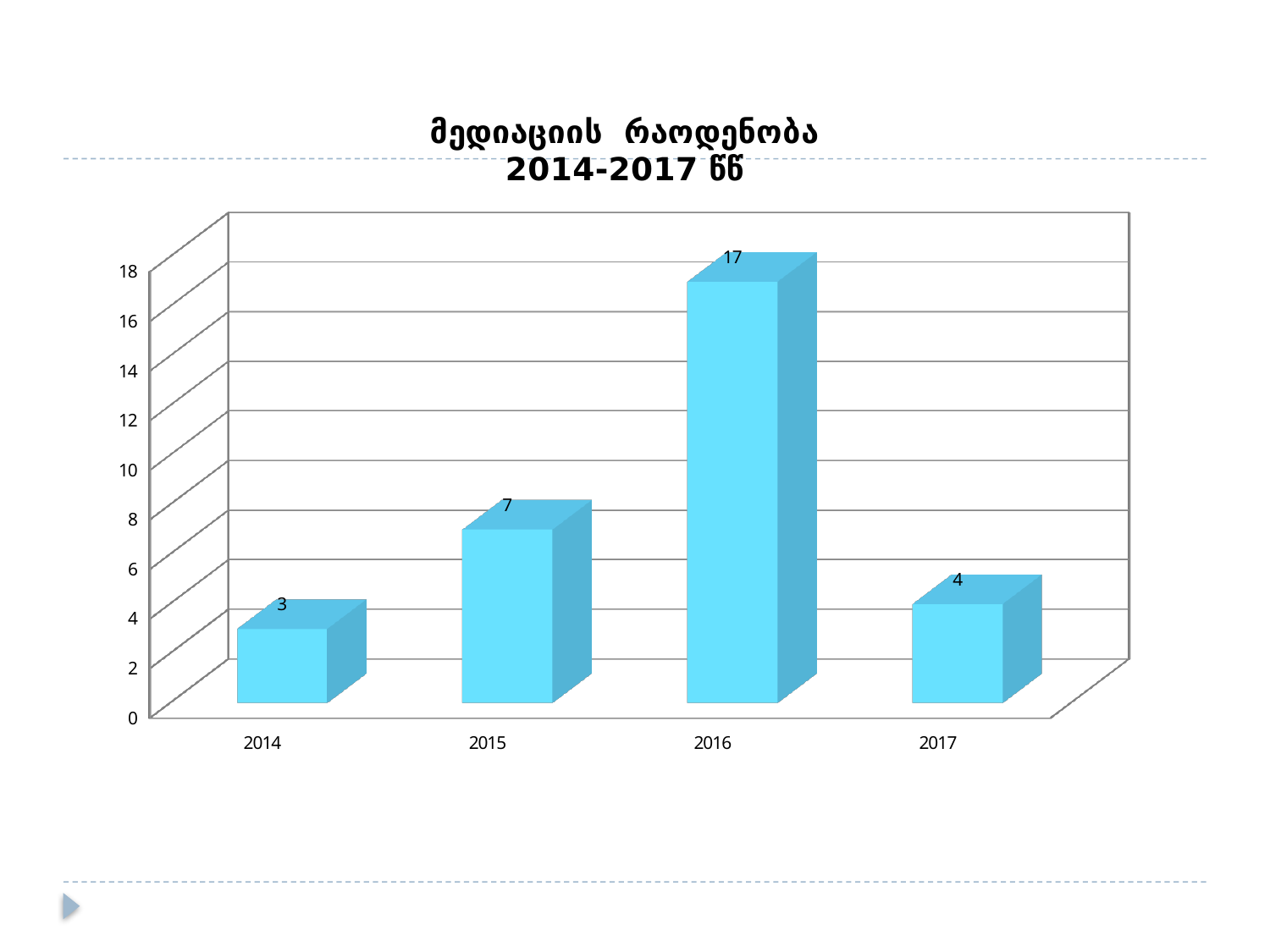
Which year has the lowest value? 2014 What is the value for 2017? 4 What is the title of the chart? მედიაციის რაოდენობა 2014-2017 წწ What is the value for 2014? 3 What kind of chart is shown on the slide? bar chart What is the value for 2015? 7 What is the value for 2016? 17 What is the difference between the values for 2016 and 2015? 10 How many years are shown on the x axis? 4 Which is larger, the value for 2015 or the value for 2017? 2015 Which year has the highest value? 2016 Is the value for 2016 greater or less than 10? greater